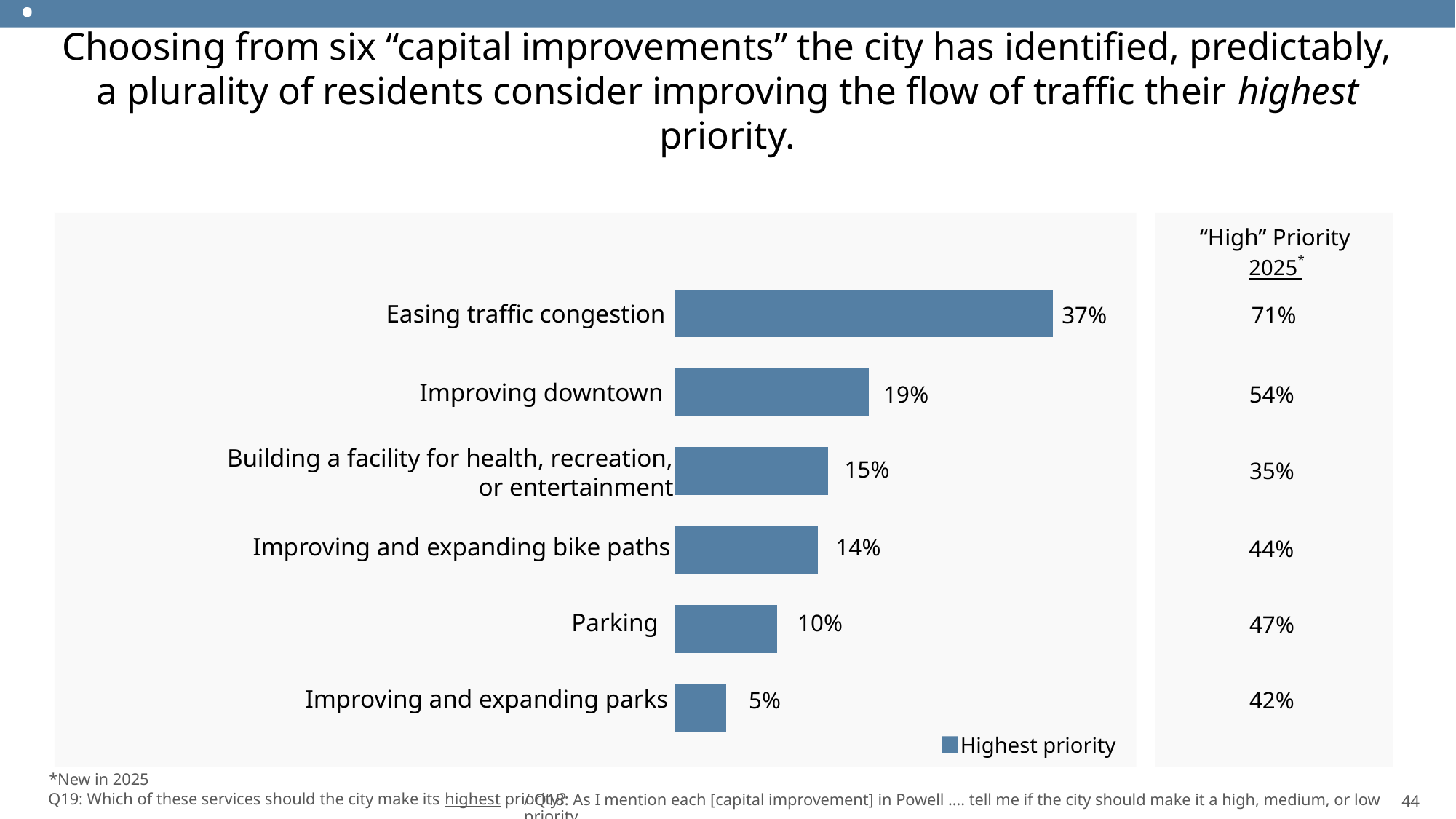
What is the "High" Priority 2025 value shown for improving downtown? 54% How many series does the legend list? 1 What percentage of residents chose easing traffic congestion as their highest priority? 37% What is the highest-priority value for improving and expanding bike paths? 14% Which category has the lowest share of residents naming it their highest priority? Improving and expanding parks How many categories are shown in the bar chart? 6 What is the highest-priority value for Parking? 10% What kind of chart is shown on the slide? Bar chart Which has a larger highest-priority share: improving downtown or Parking? Improving downtown What is the legend entry for the bar series? Highest priority What is the difference in percentage points between easing traffic congestion and improving downtown as highest priority? 18 Which category has the highest share of residents naming it their highest priority? Easing traffic congestion